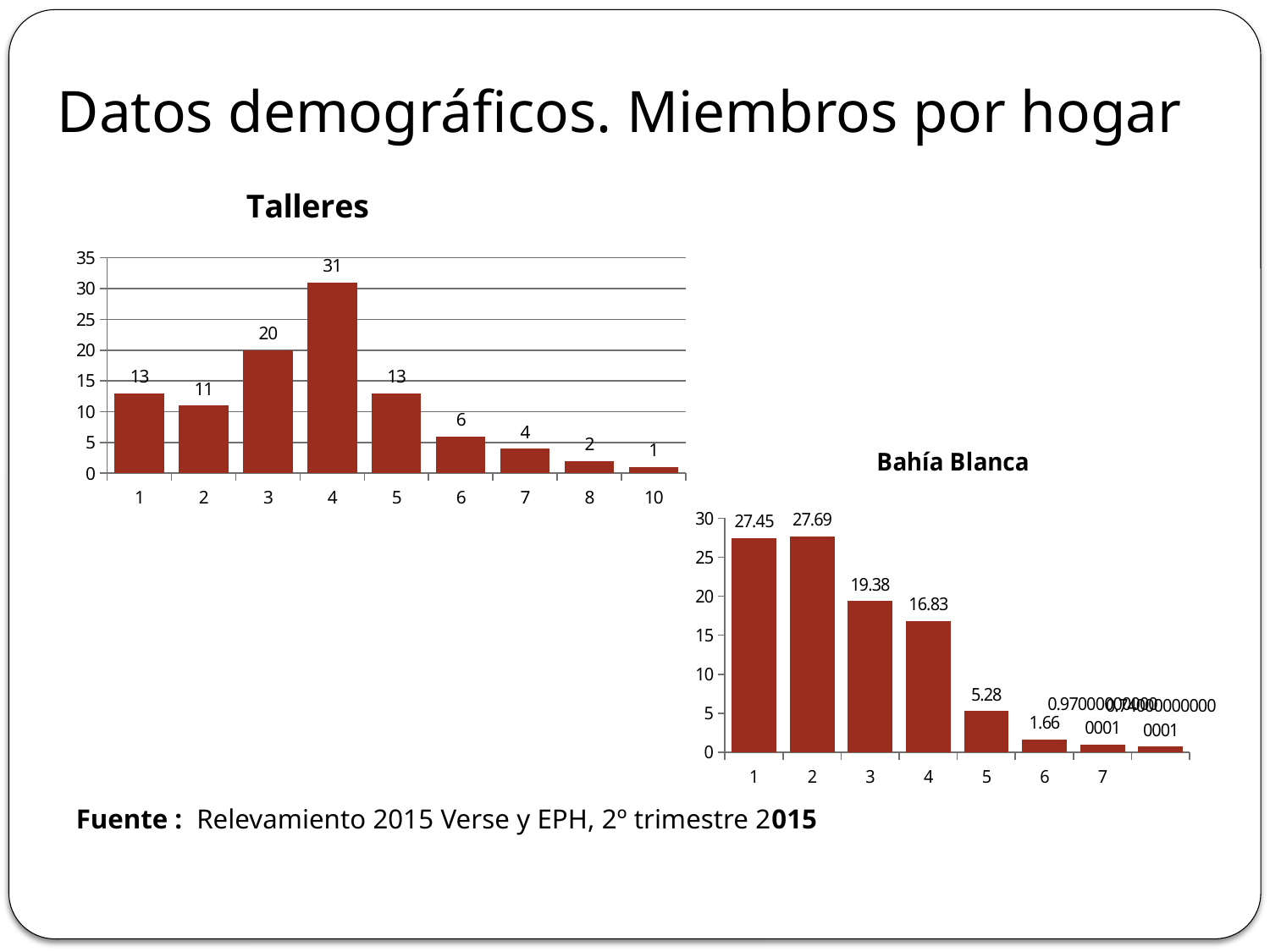
In the Talleres chart, what is the value for category 4? 31 In the Talleres chart, what is the value for category 3? 20 In the Bahía Blanca chart, what is the value for category 3? 19.38 In the Talleres chart, how many categories are shown on the x axis? 9 In the Talleres chart, which category has the lowest value? 10 In the Talleres chart, which category has the highest value? 4 In the Talleres chart, is the value for category 2 greater or less than 10? greater What kind of chart is the Talleres chart? bar chart In the Talleres chart, what is the difference between the values for categories 4 and 3? 11 In the Bahía Blanca chart, is the value for category 4 larger or smaller than the value for category 5? larger In the Bahía Blanca chart, what is the value for category 5? 5.28 In the Bahía Blanca chart, what is the difference between the values for categories 3 and 4? 2.55